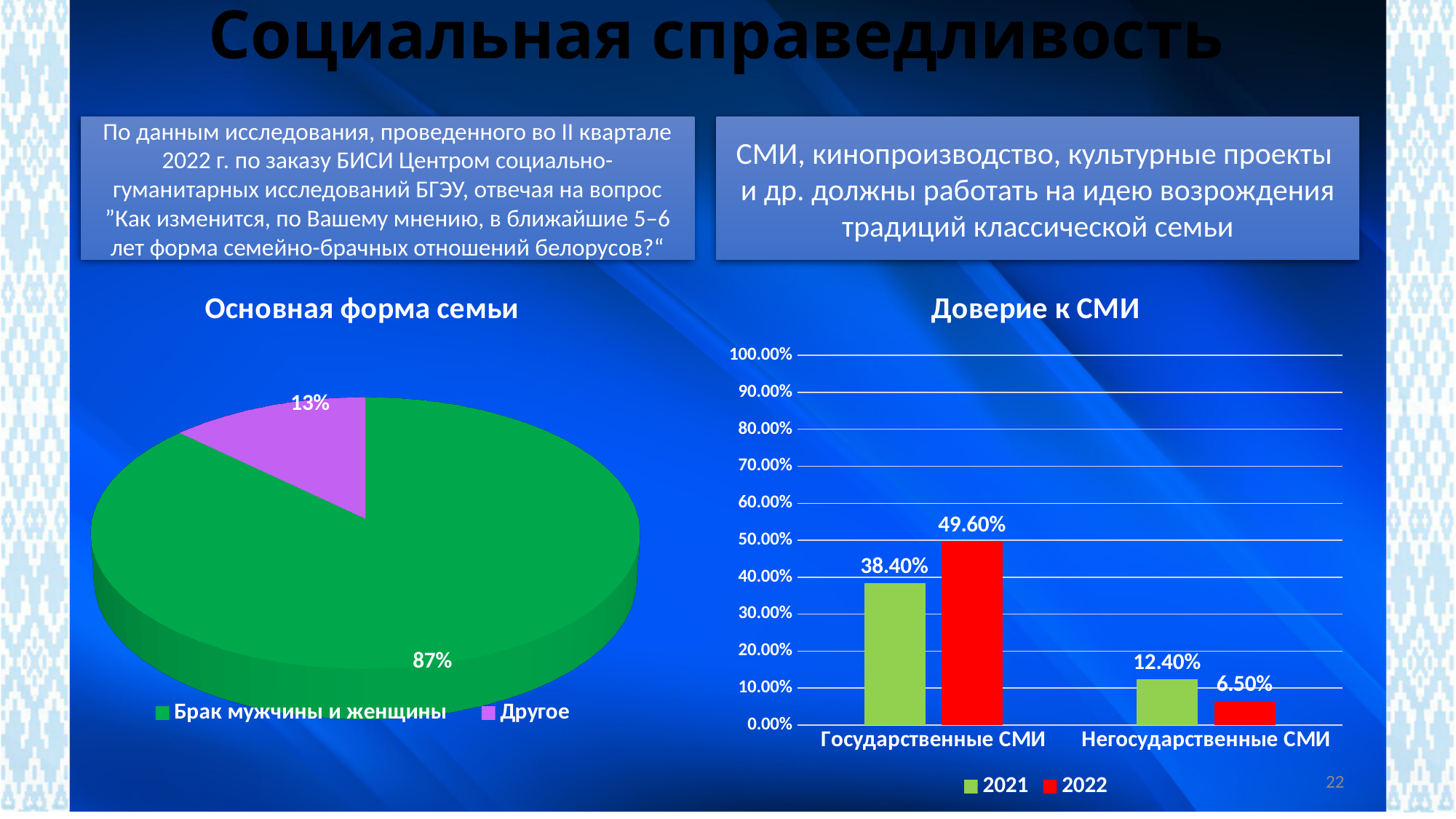
In the "Основная форма семьи" chart, what share does "Брак мужчины и женщины" have? 87% In the "Доверие к СМИ" chart, what is the difference between the 2022 and 2021 values for "Государственные СМИ"? 11.20% How many series does the legend of the "Доверие к СМИ" chart list? 2 What kind of chart is "Основная форма семьи"? Pie chart What kind of chart is "Доверие к СМИ"? Bar chart In the "Доверие к СМИ" chart, which colour represents the 2022 series? Red In the "Доверие к СМИ" chart, what is the 2022 value for "Государственные СМИ"? 49.60% In the "Доверие к СМИ" chart, what is the 2021 value for "Негосударственные СМИ"? 12.40% How many slices does the "Основная форма семьи" pie chart have? 2 In the "Доверие к СМИ" chart, is the 2021 value for "Негосударственные СМИ" larger or smaller than the 2022 value? Larger In the "Основная форма семьи" chart, what share does "Другое" have? 13% In the "Доверие к СМИ" chart, which category has the lowest 2022 value? Негосударственные СМИ